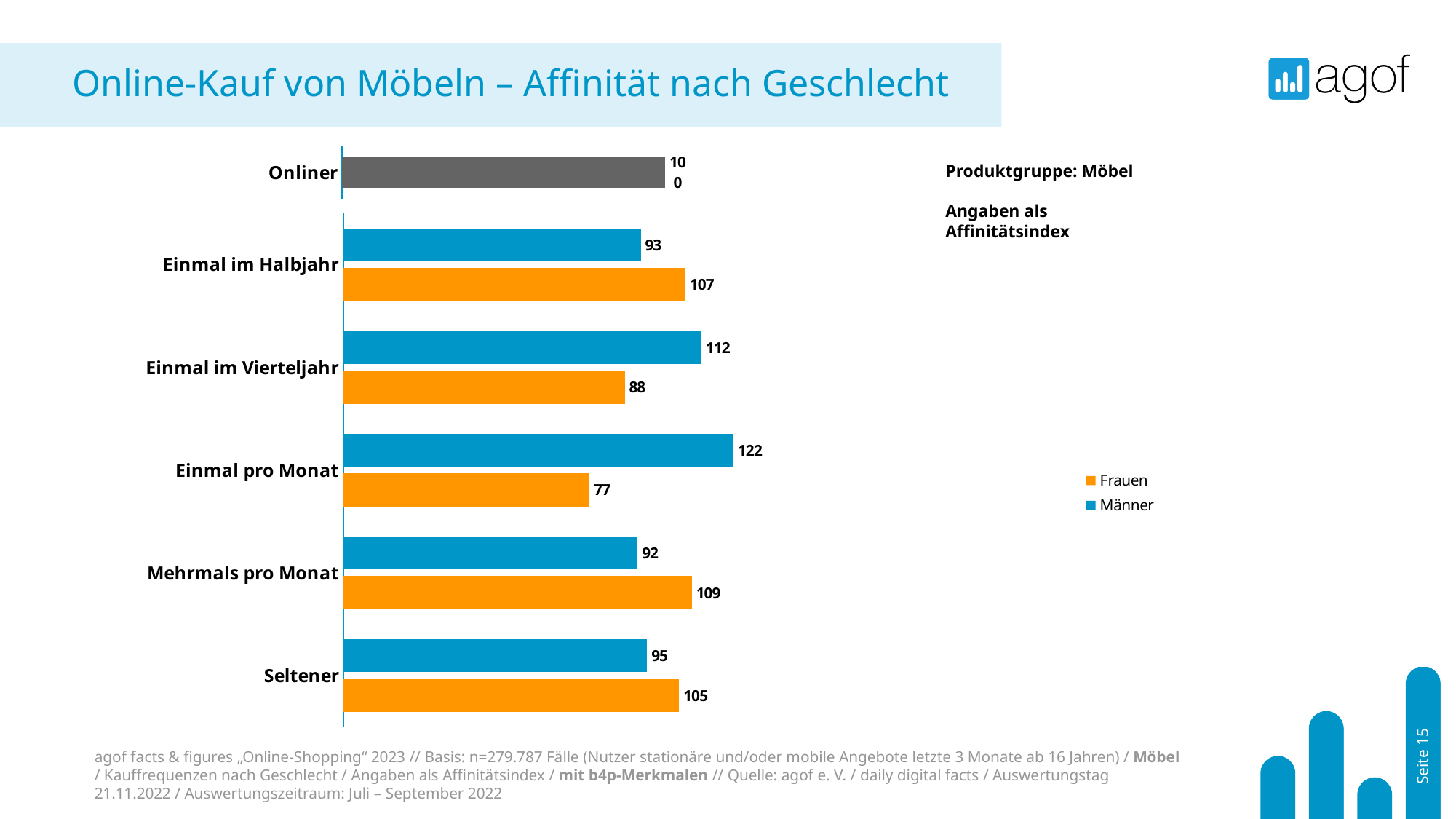
What is the difference between the Männer and Frauen values for Einmal pro Monat? 45 What kind of chart is shown on the slide? Bar chart What is the difference between the Frauen and Männer values for Mehrmals pro Monat? 17 Which category has the lowest Frauen value? Einmal pro Monat How many series does the legend list? 2 Which colour represents Frauen in the chart? Orange For Einmal im Vierteljahr, which is larger: the Männer value or the Frauen value? Männer Which category has the highest Männer value? Einmal pro Monat What is the Männer value for Einmal pro Monat? 122 What is the Frauen value for Einmal im Vierteljahr? 88 What is the Männer value for Seltener? 95 What is the Frauen value for Einmal im Halbjahr? 107